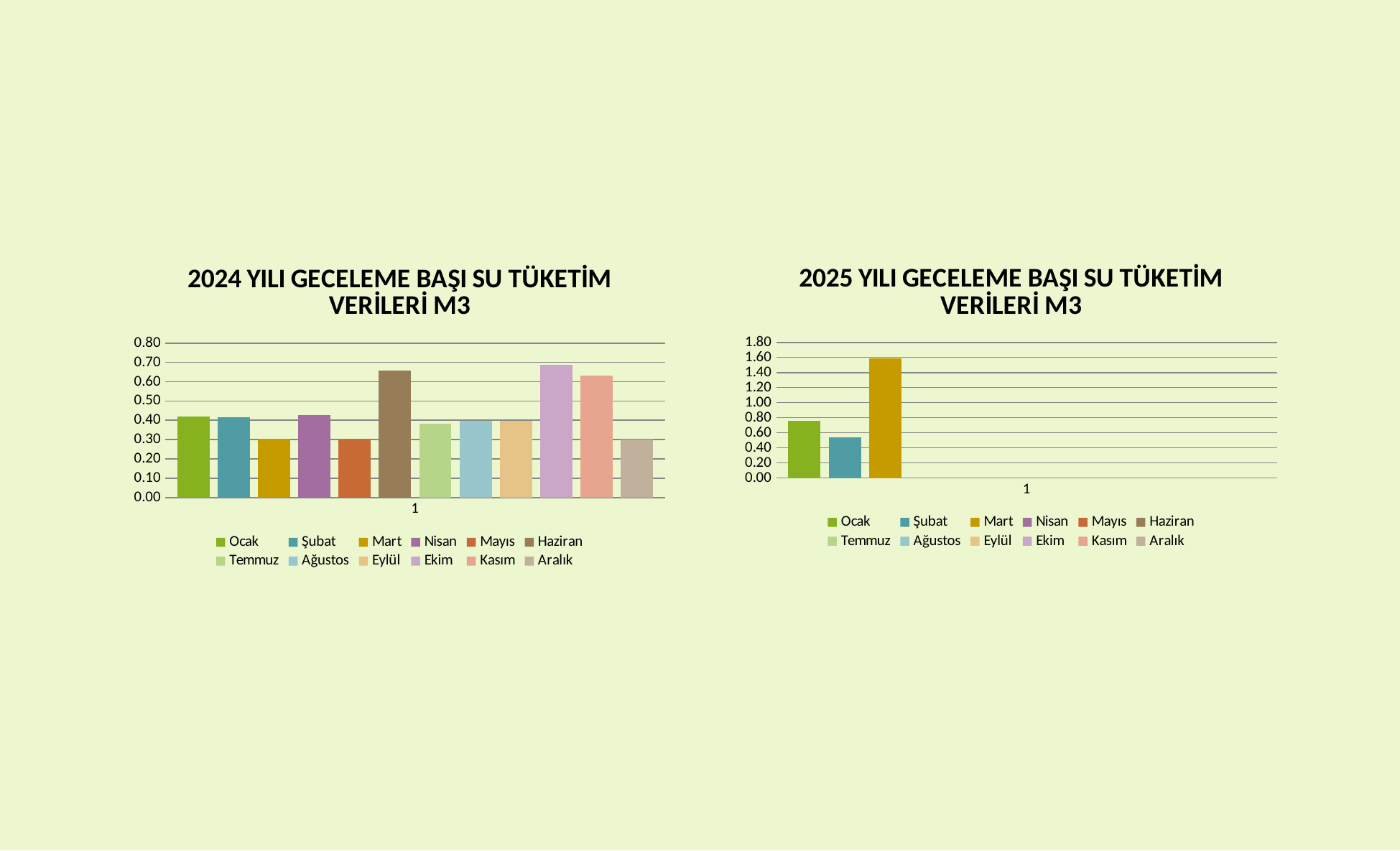
What kind of chart is the 2024 YILI GECELEME BAŞI SU TÜKETİM VERİLERİ M3 chart? bar chart How many series does the legend of the 2025 YILI GECELEME BAŞI SU TÜKETİM VERİLERİ M3 chart list? 12 What is the title of the chart on the left side of the slide? 2024 YILI GECELEME BAŞI SU TÜKETİM VERİLERİ M3 In the 2025 YILI GECELEME BAŞI SU TÜKETİM VERİLERİ M3 chart, which month has the highest value? Mart In the 2025 YILI GECELEME BAŞI SU TÜKETİM VERİLERİ M3 chart, how many bars are plotted? 3 In the 2024 YILI GECELEME BAŞI SU TÜKETİM VERİLERİ M3 chart, is the value for Haziran greater or less than 0.60? greater In the 2025 YILI GECELEME BAŞI SU TÜKETİM VERİLERİ M3 chart, which is larger, the value for Ocak or the value for Mart? Mart In the 2024 YILI GECELEME BAŞI SU TÜKETİM VERİLERİ M3 chart, is the value for Temmuz greater or less than 0.50? less In the 2025 YILI GECELEME BAŞI SU TÜKETİM VERİLERİ M3 chart, is the value for Mart greater or less than 1.40? greater In the 2024 YILI GECELEME BAŞI SU TÜKETİM VERİLERİ M3 chart, which is larger, the value for Haziran or the value for Temmuz? Haziran